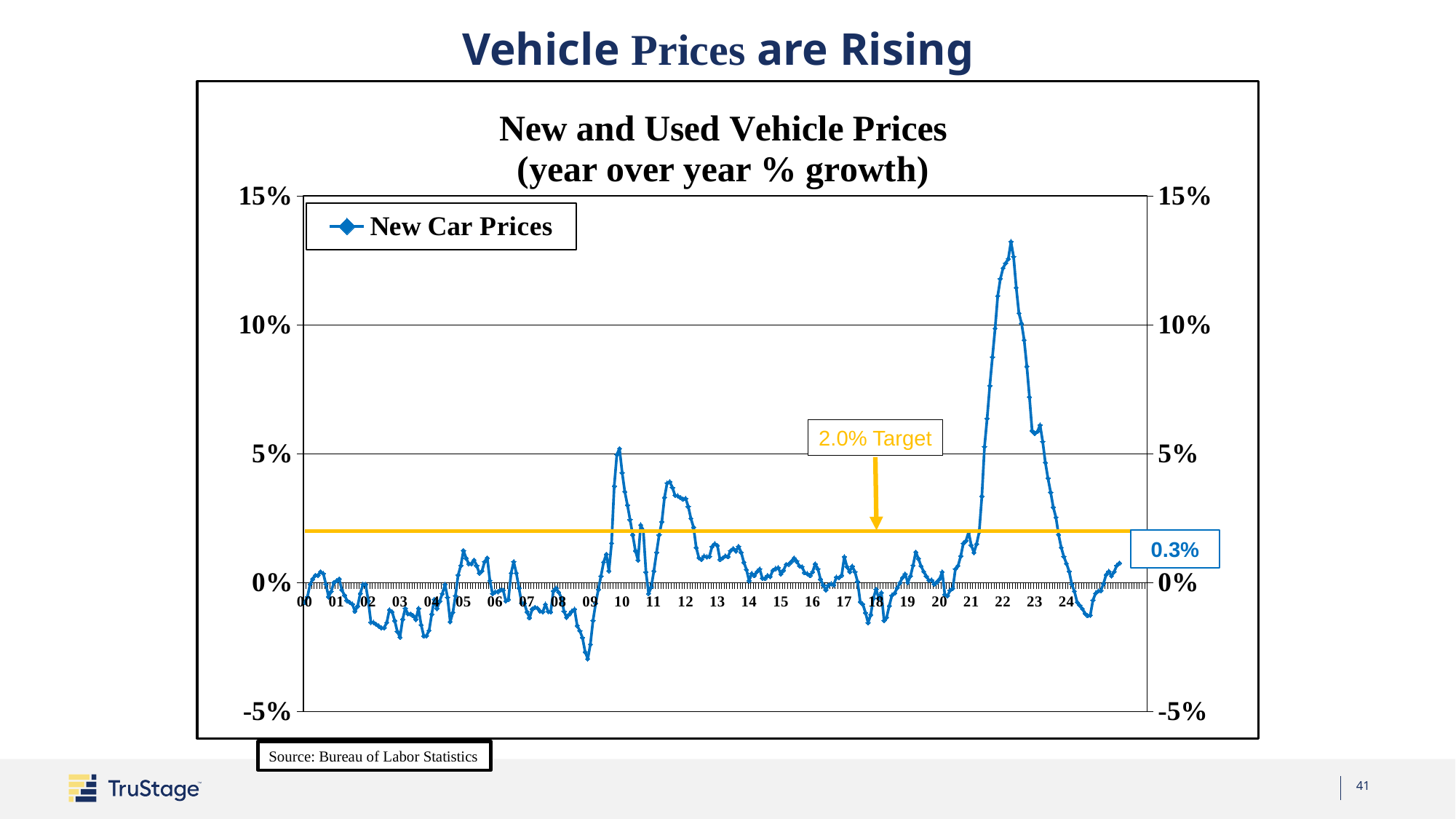
What series name appears in the legend? New Car Prices What is the title of the chart? New and Used Vehicle Prices (year over year % growth) Is the most recent value of New Car Prices (0.3%) greater or less than the 2.0% target? less Does New Car Prices growth rise or fall between 22 and 24? fall What value does the horizontal target line represent? 2.0% Is the peak value of New Car Prices around 22 greater or less than 10%? greater What kind of chart is shown on the slide? Line chart What is the most recent value of New Car Prices labelled at the right end of the line? 0.3% In which year on the x axis does New Car Prices growth reach its highest point? 22 Is the lowest value of New Car Prices around 09 greater or less than 0%? less How many series does the legend list? 1